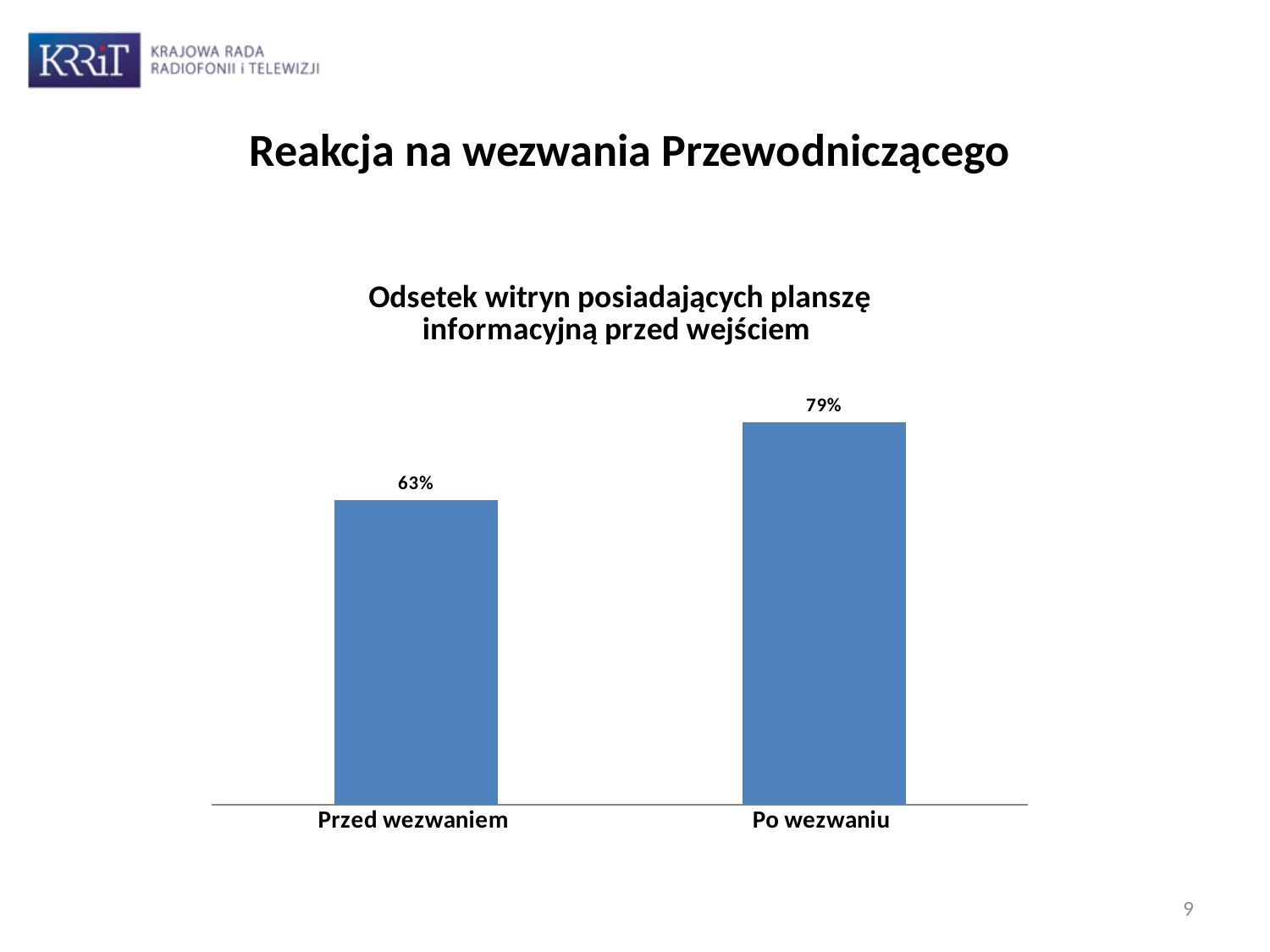
What is the difference between the values for "Po wezwaniu" and "Przed wezwaniem"? 16% What is the value for "Przed wezwaniem"? 63% What colour are the bars in the chart? Blue What is the title of the chart? Odsetek witryn posiadających planszę informacyjną przed wejściem Which category has the highest value? Po wezwaniu Do the values rise or fall from "Przed wezwaniem" to "Po wezwaniu"? Rise How many categories are shown in the chart? 2 What kind of chart is shown on the slide? Bar chart Which is larger, the value for "Przed wezwaniem" or the value for "Po wezwaniu"? Po wezwaniu What is the value for "Po wezwaniu"? 79% Which category has the lowest value? Przed wezwaniem